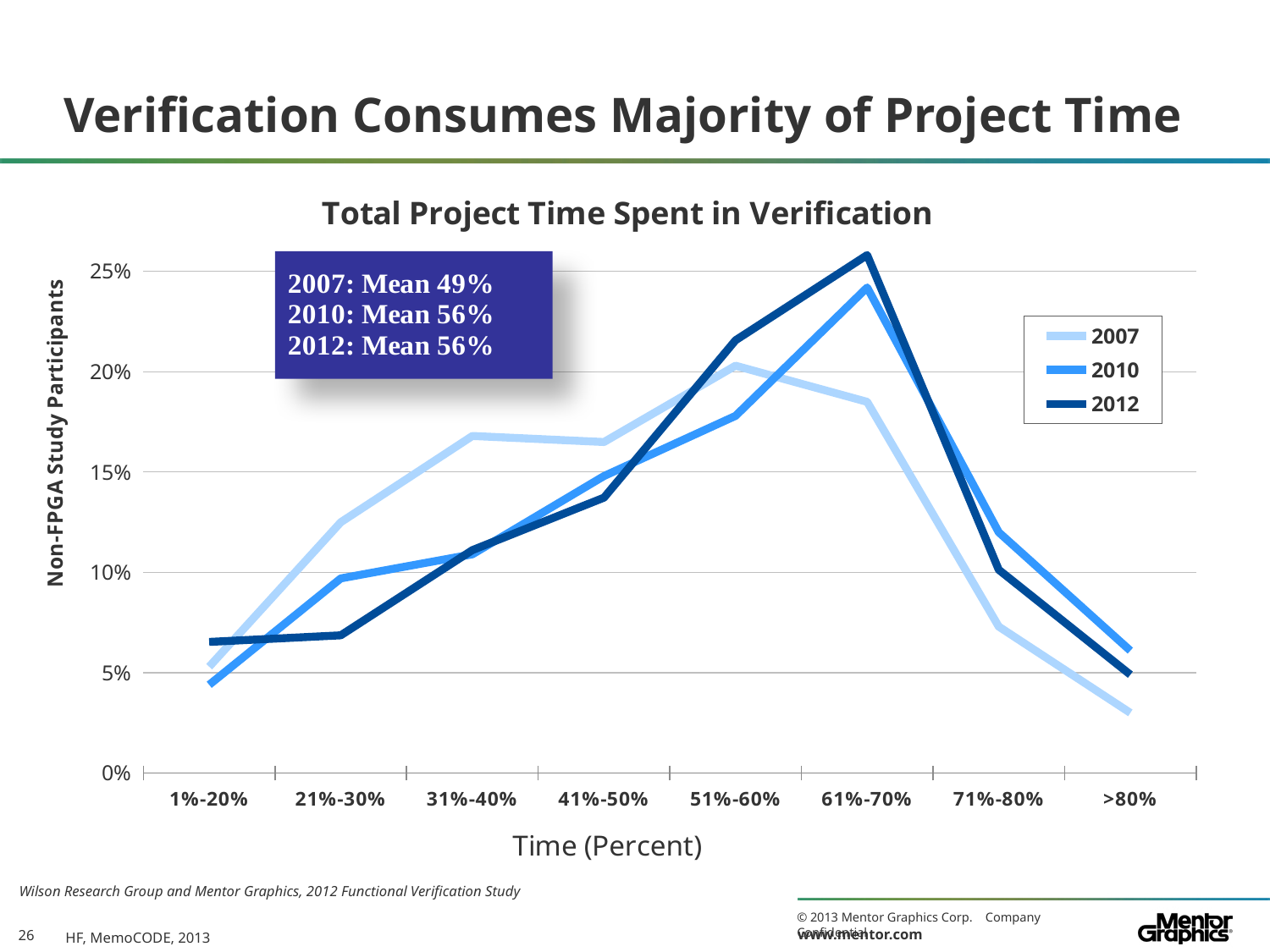
Is the value for 2007 at >80% greater or less than 5%? less How many series does the legend list? 3 At 61%-70%, which series has the larger value, 2012 or 2007? 2012 Does the 2012 series rise or fall from 1%-20% to 61%-70%? rise Which time category has the lowest value for the 2007 series? >80% At 31%-40%, which series has the larger value, 2007 or 2012? 2007 What kind of chart is shown on the slide? line chart Is the value for 2012 at 61%-70% greater or less than 25%? greater Which time category has the highest value for the 2012 series? 61%-70% Is the value for 2007 at 61%-70% greater or less than 20%? less How many categories are shown on the x axis? 8